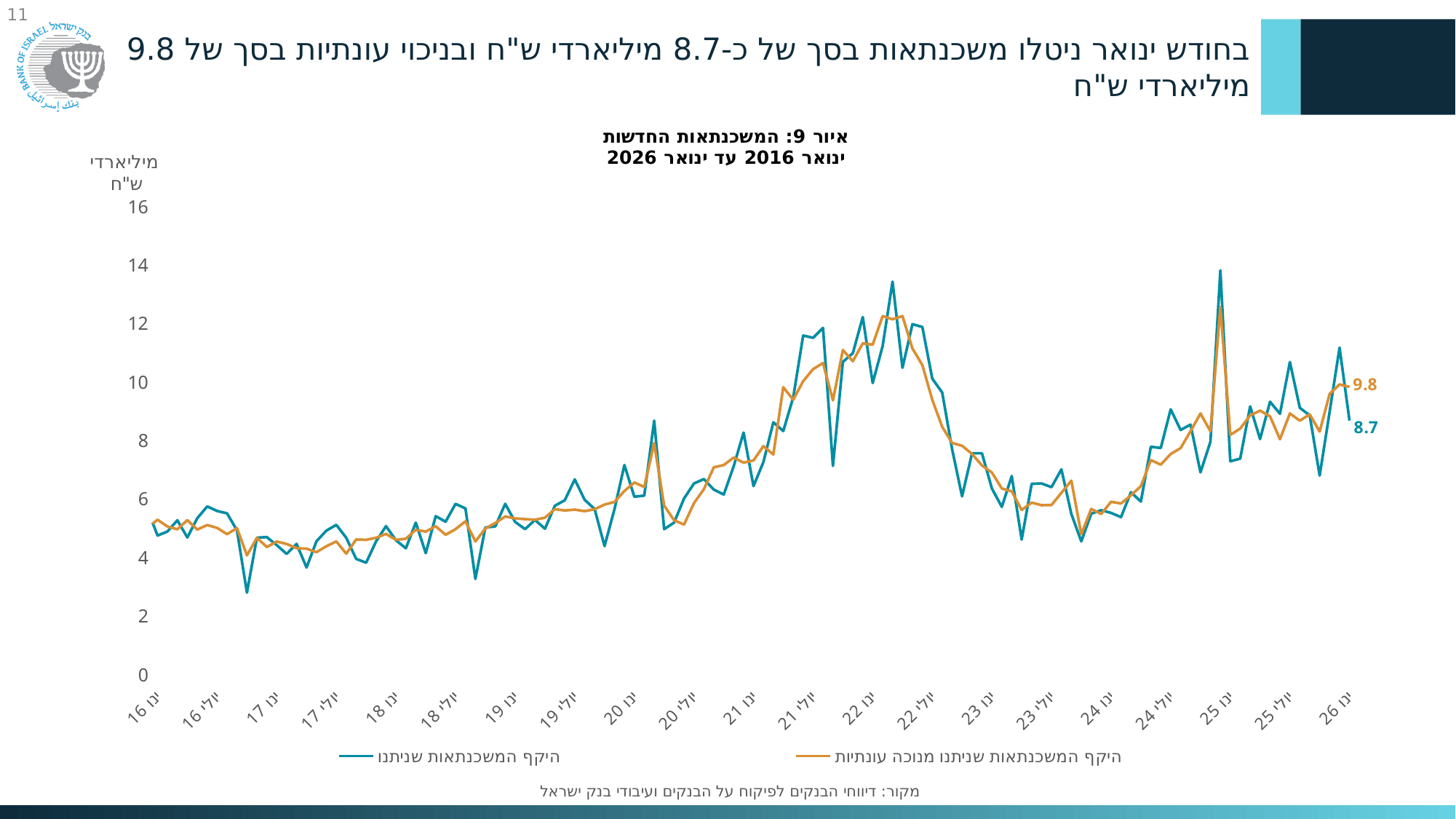
What is the difference between the two labelled values at ינו 26 (9.8 and 8.7)? 1.1 What is the title of the chart? איור 9: המשכנתאות החדשות ינואר 2016 עד ינואר 2026 What kind of chart is shown on the slide? line chart Is the value of the seasonally adjusted series at ינו 22 greater or less than 10? greater How many series does the legend list? 2 Overall, do the values rise or fall from ינו 16 to ינו 26? rise What unit is shown on the y axis? מיליארדי ש"ח What is the labelled value of the unadjusted series (היקף המשכנתאות שניתנו) at ינו 26? 8.7 What is the labelled value of the seasonally adjusted series (היקף המשכנתאות שניתנו מנוכה עונתיות) at ינו 26? 9.8 At ינו 26, which series has the higher labelled value: the seasonally adjusted series or the unadjusted series? the seasonally adjusted series (9.8) Is the value of the unadjusted series (היקף המשכנתאות שניתנו) at ינו 16 greater or less than 8? less